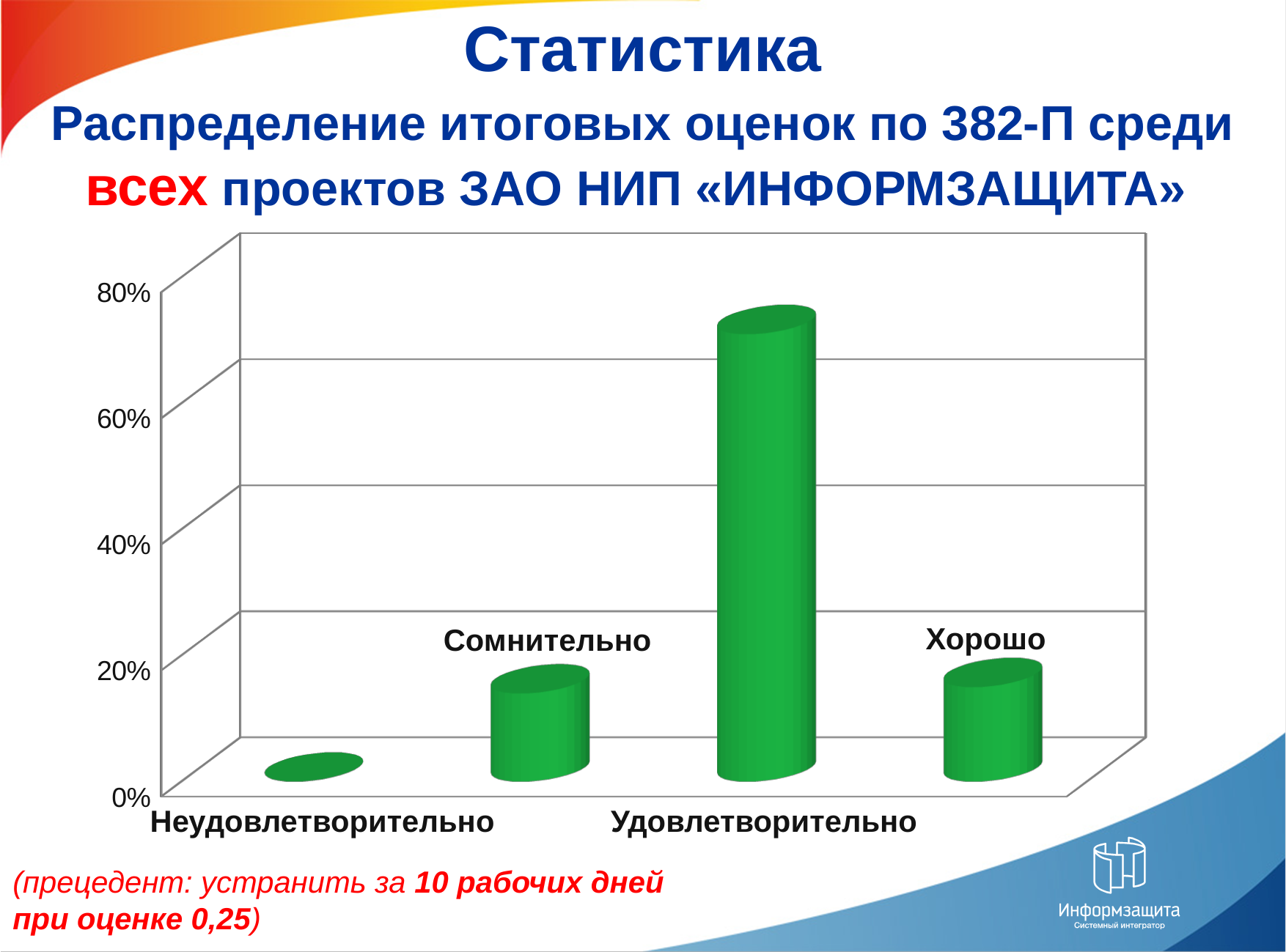
What is the highest value shown on the vertical axis? 80% Which is larger, the value for Удовлетворительно or the value for Сомнительно? Удовлетворительно What colour are the bars in the chart? green Which category has the highest value? Удовлетворительно Is the value for Хорошо greater or less than 40%? less How many categories are shown on the chart? 4 Is the value for Удовлетворительно greater or less than 60%? greater Is the value for Удовлетворительно greater or less than 80%? less Which is larger, the value for Хорошо or the value for Неудовлетворительно? Хорошо Which category has the lowest value? Неудовлетворительно What kind of chart is shown on the slide? bar chart